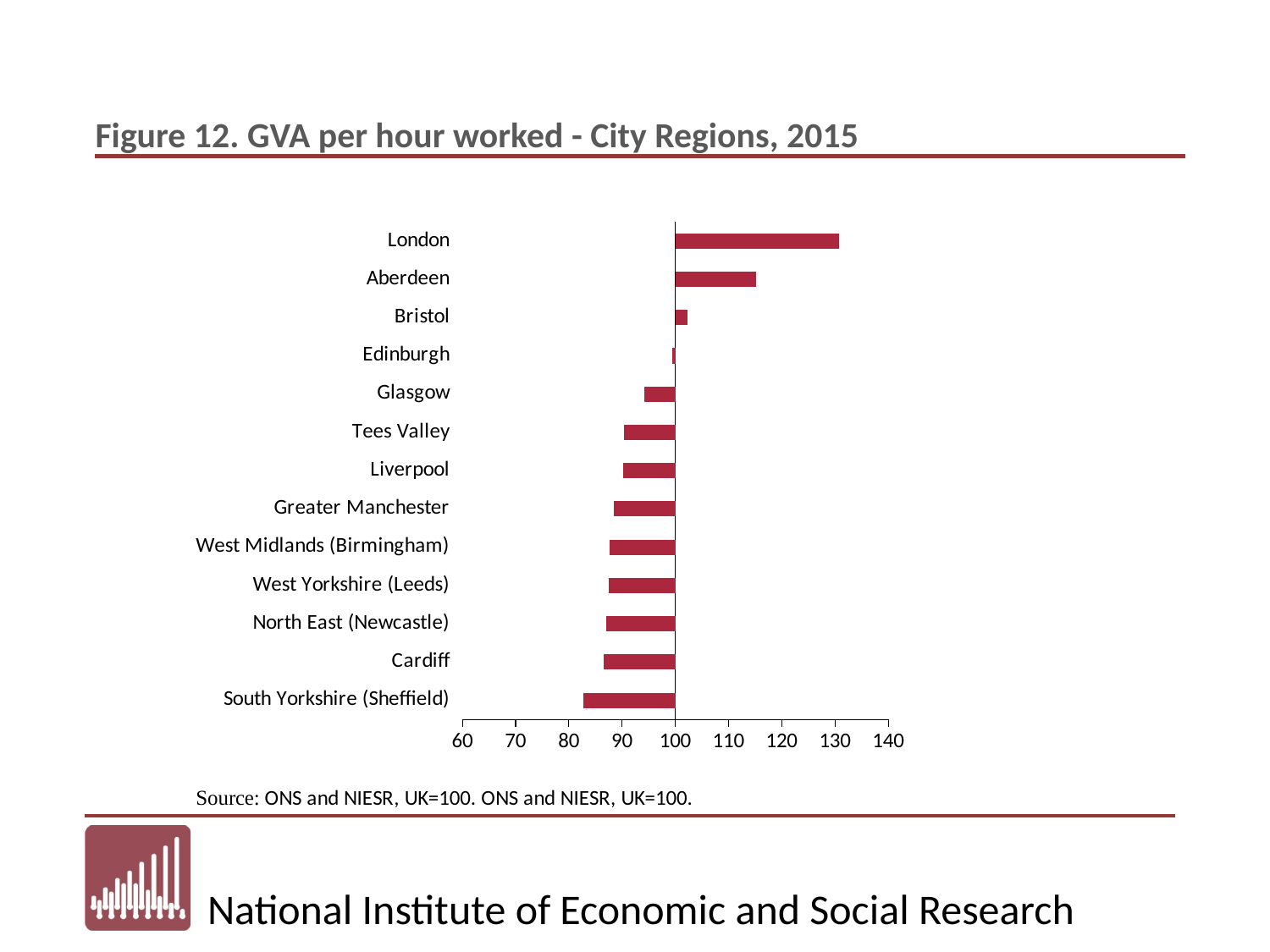
Is the value for Bristol greater or less than 100? greater Which has a higher GVA per hour worked, London or Aberdeen? London Which has a higher GVA per hour worked, Glasgow or South Yorkshire (Sheffield)? Glasgow How many city regions are shown in the chart? 13 Is the value for South Yorkshire (Sheffield) greater or less than 90? less Which city region has the highest GVA per hour worked? London Is the value for Glasgow greater or less than 100? less What kind of chart is shown on the slide? Bar chart Which city region has the lowest GVA per hour worked? South Yorkshire (Sheffield) What is the title of the chart? Figure 12. GVA per hour worked - City Regions, 2015